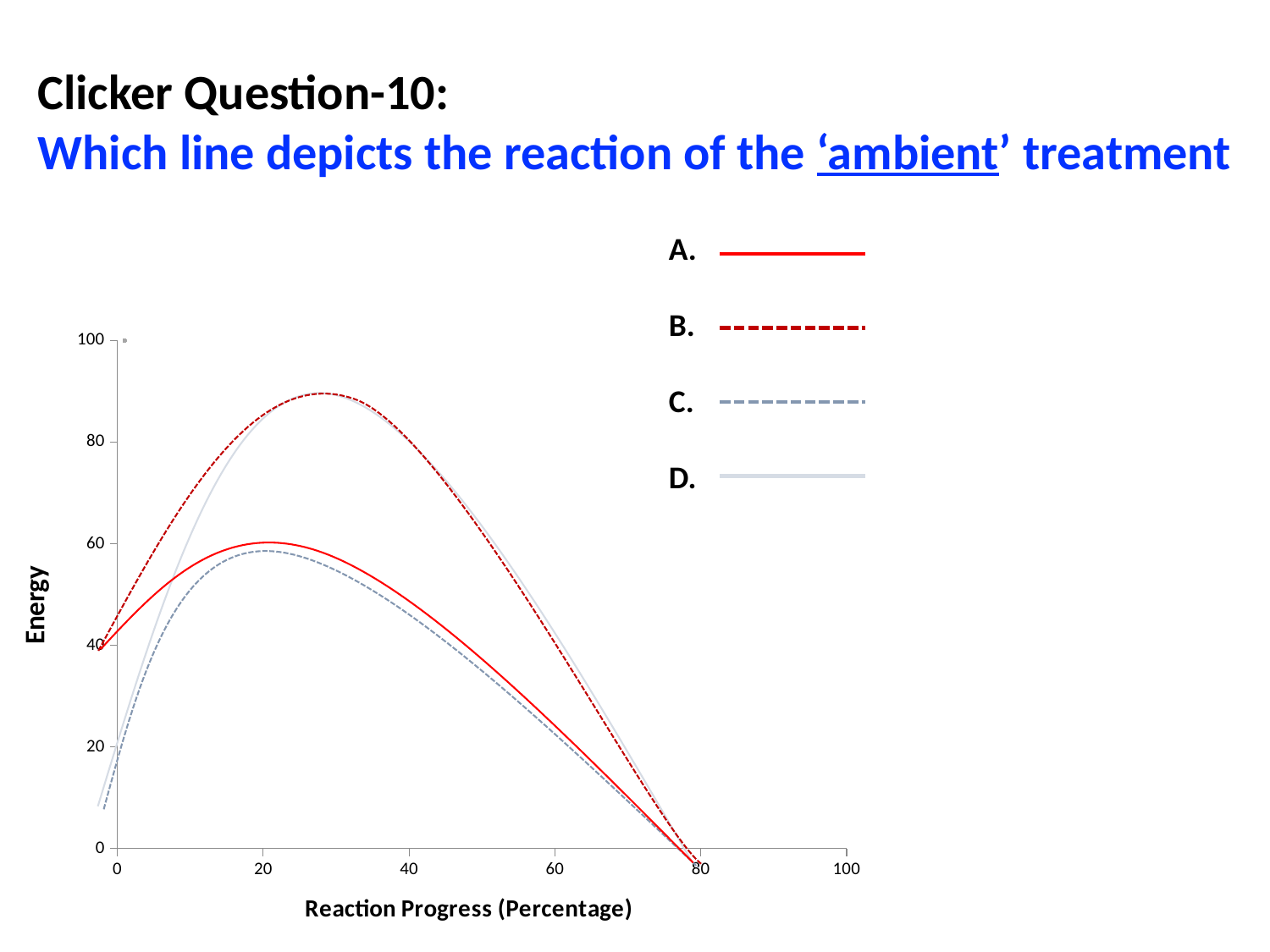
At what reaction progress value do all four lines meet at an energy of 0? 80 Do the lines rise or fall as reaction progress increases from 40 to 80? fall What is the title of the y axis? Energy What is the highest value shown on the y axis? 100 Which line reaches a higher peak energy, line A (solid red) or line B (dashed dark red)? line B Is the energy of line A (solid red) at a reaction progress of 20 greater or less than 40? greater What is the title of the x axis? Reaction Progress (Percentage) What kind of chart is shown on the slide? line chart How many lines does the legend (options A to D) list? 4 Is the peak energy of line A (solid red) greater or less than 80? less Is the peak energy of line B (dashed dark red) greater or less than 80? greater